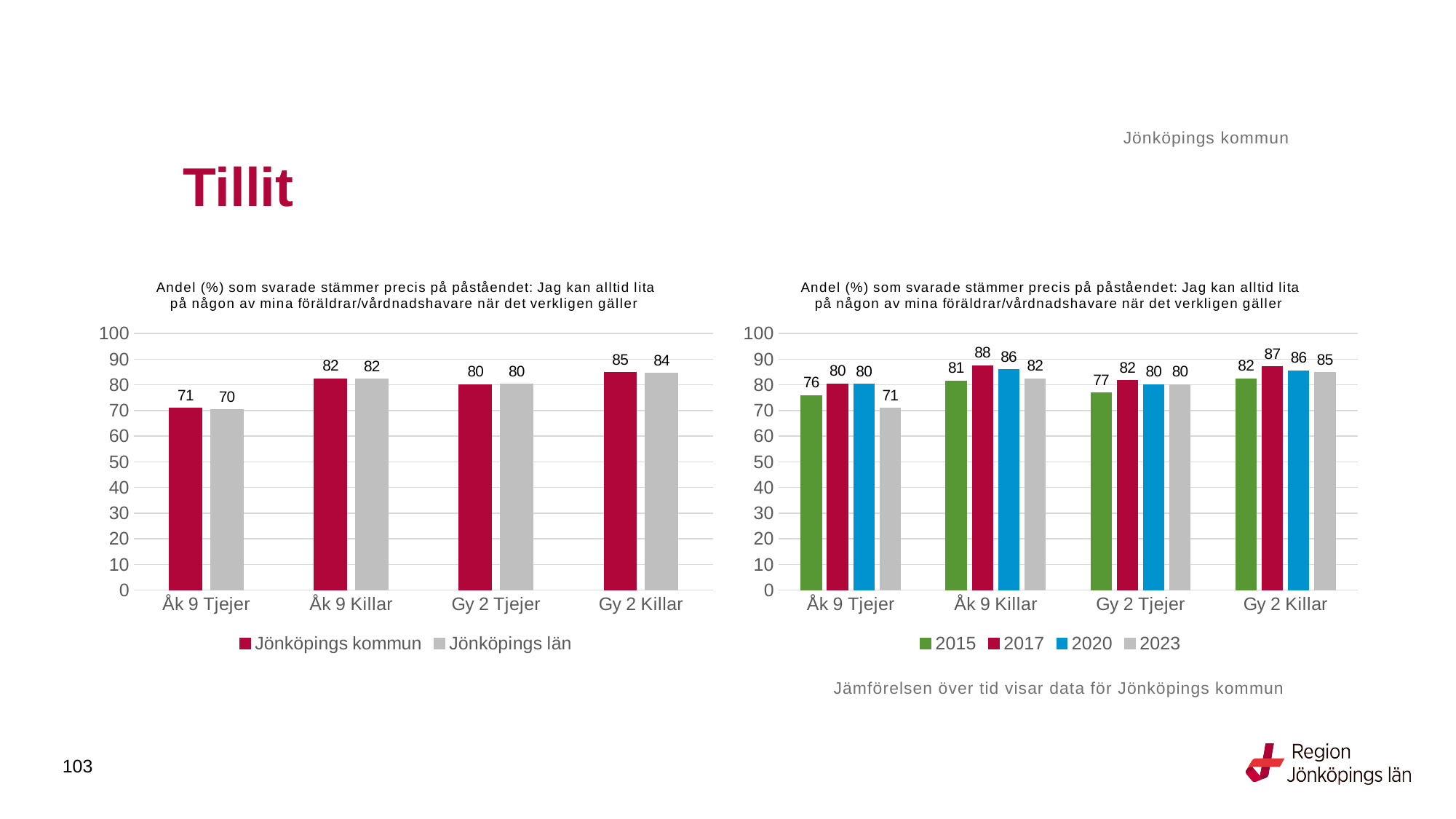
In the left chart, what is the value for Jönköpings län for Gy 2 Killar? 84 In the right chart, which year has the lowest value for Gy 2 Tjejer? 2015 In the right chart, what is the difference between the 2017 and 2023 values for Åk 9 Tjejer? 9 In the left chart, which category has the highest value for Jönköpings kommun? Gy 2 Killar In the right chart, what is the value for 2023 for Åk 9 Tjejer? 71 In the right chart, what is the value for 2017 for Åk 9 Killar? 88 In the left chart, what is the value for Jönköpings kommun for Åk 9 Tjejer? 71 In the left chart, which category has the lowest value for Jönköpings län? Åk 9 Tjejer In the right chart, how many series does the legend list? 4 What kind of chart is the right chart? Bar chart In the left chart, how many series does the legend list? 2 In the left chart, what is the difference between Jönköpings kommun and Jönköpings län for Åk 9 Tjejer? 1